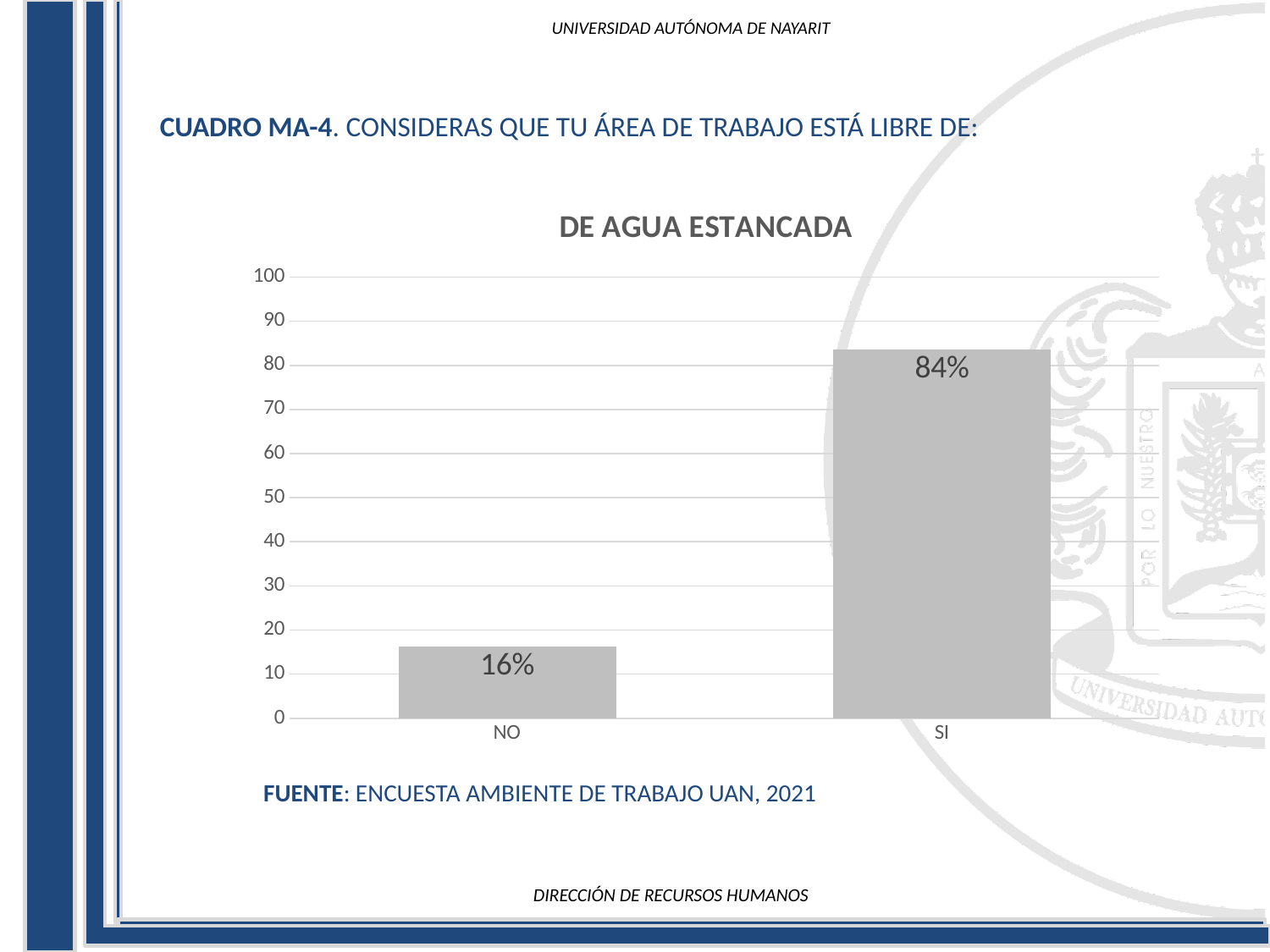
What is the value for SI? 84% Is the value for SI greater or less than 80? greater What kind of chart is shown on the slide? bar chart Which category has the lowest value? NO What is the value for NO? 16% What is the title of the chart? DE AGUA ESTANCADA How many categories are shown on the x axis? 2 Is the value for NO greater or less than 20? less What is the maximum value shown on the y axis? 100 Which category has the highest value? SI Which is larger, the value for NO or the value for SI? SI What is the difference between the values for SI and NO? 68%